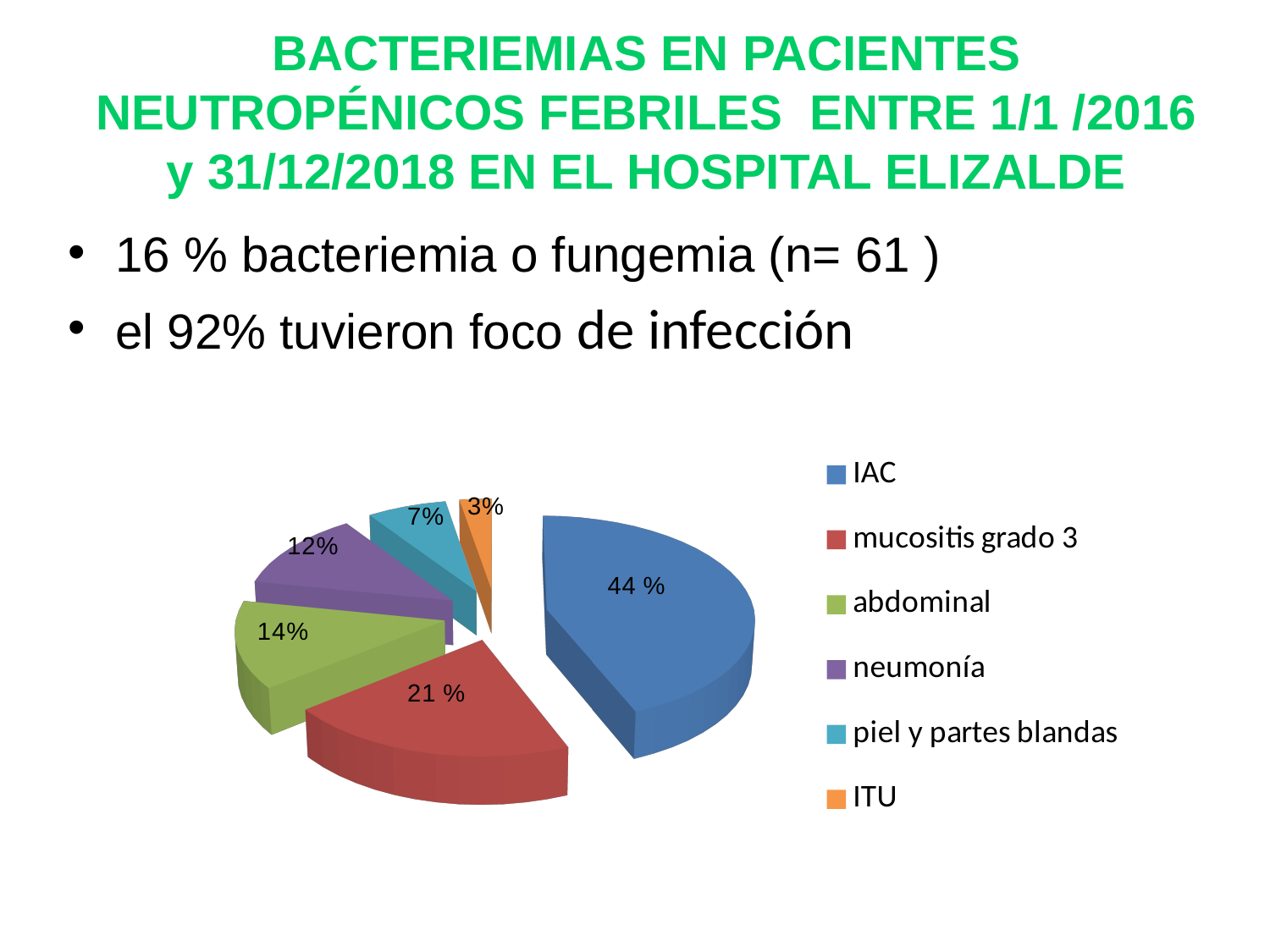
What is the value for mucositis grado 3? 21 % What kind of chart is shown on the slide? pie chart What is the value for neumonía? 12% What is the value for piel y partes blandas? 7% What is the value for abdominal? 14% How many categories does the legend list? 6 What is the value for IAC? 44 % What is the value for ITU? 3% What is the difference between the value for IAC and the value for mucositis grado 3? 23 % Which is larger, the value for abdominal or the value for neumonía? abdominal Which category has the smallest share of the pie? ITU Which category has the largest share of the pie? IAC